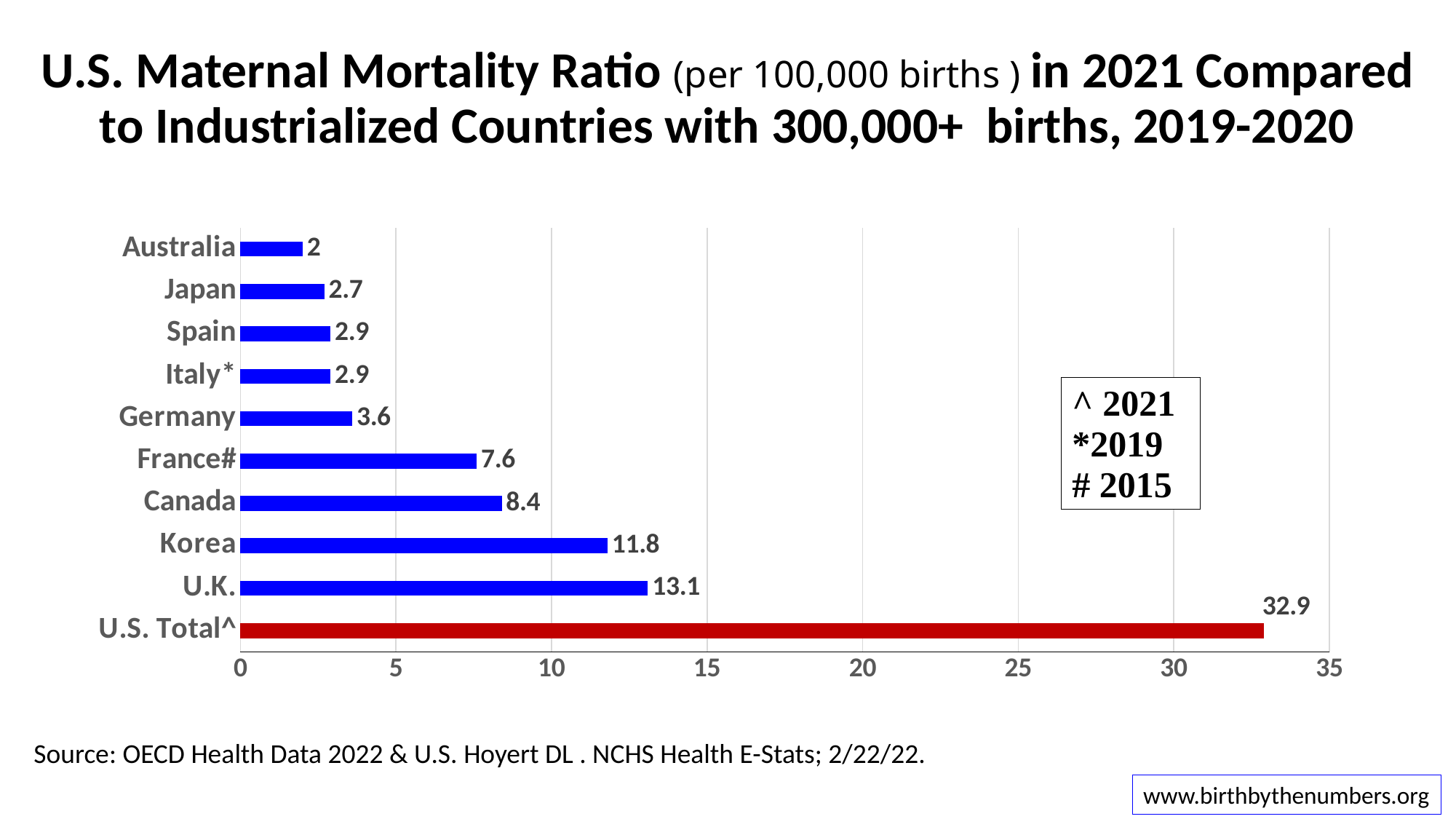
Which has a higher maternal mortality ratio, Korea or Canada? Korea What colour is the bar for U.S. Total^? Red What is the difference between the Germany value and the Japan value? 0.9 Which country has the lowest maternal mortality ratio? Australia Which category has the highest maternal mortality ratio? U.S. Total^ What is the value shown for Canada? 8.4 What is the value shown for France#? 7.6 What kind of chart is shown on the slide? Bar chart What is the value shown for Korea? 11.8 What is the difference between the U.S. Total^ value and the U.K. value? 19.8 What is the maternal mortality ratio shown for the U.S. Total^? 32.9 How many countries or categories are plotted in the chart? 10